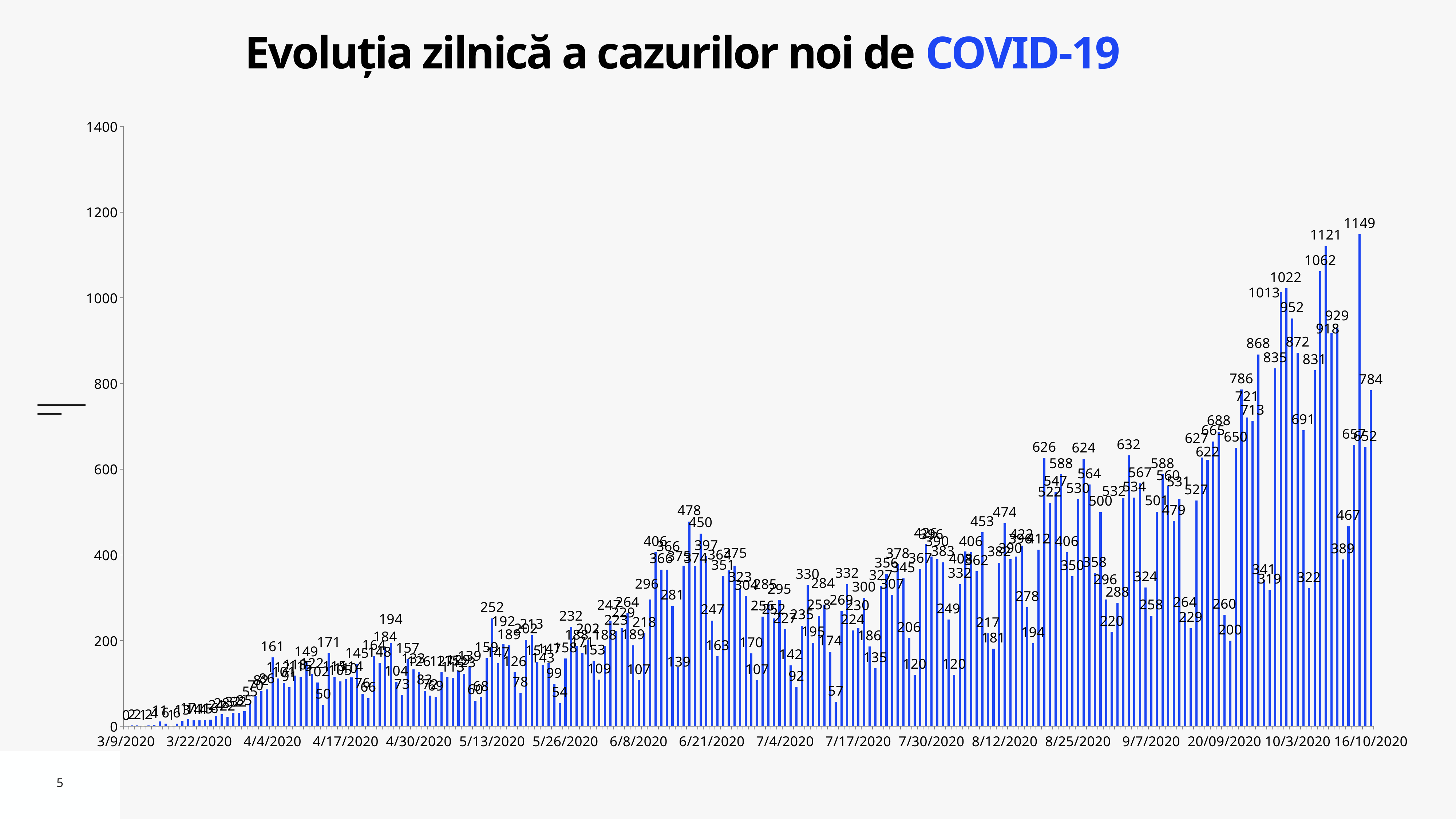
Overall, do the daily values rise or fall from March to October 2020? rise What kind of chart is shown on the slide? bar chart What is the highest tick value shown on the vertical axis? 1400 What is the value of the first bar, at 3/9/2020? 0 Is the value for 4/4/2020 greater or less than 200? less What is the difference between the two highest labelled values, 1149 and 1121? 28 Which is larger: the highest bar (1149) or the last bar at 16/10/2020 (784)? 1149 What is the value of the last bar, at 16/10/2020? 784 Is the highest bar in the chart greater or less than 1000? greater What is the difference between the highest value (1149) and the last value (784)? 365 What is the title of the chart? Evoluția zilnică a cazurilor noi de COVID-19 What is the highest daily value shown in the chart? 1149